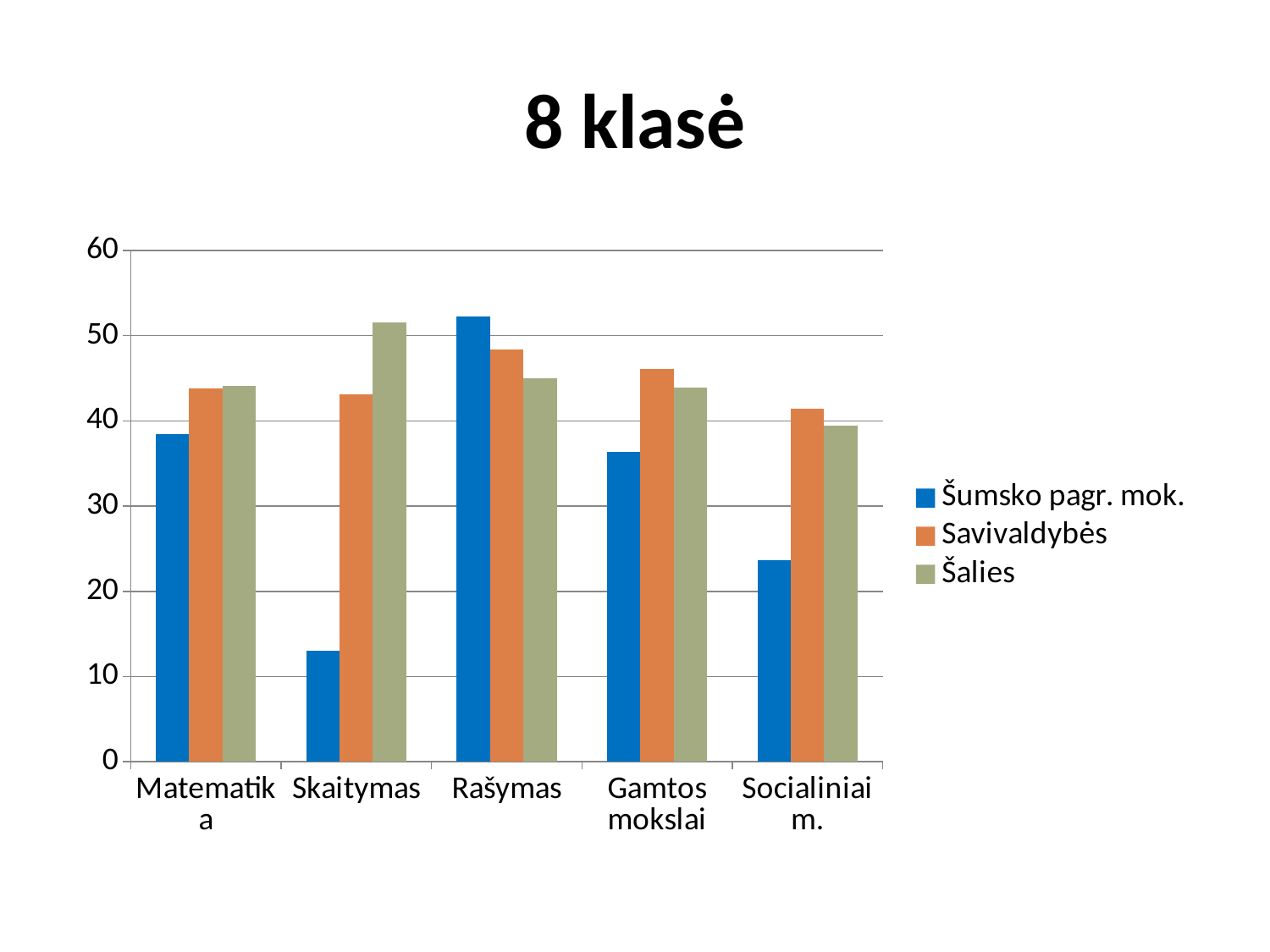
Is the Šumsko pagr. mok. value for Rašymas greater or less than 50? greater For which category is the Šalies value highest? Skaitymas Is the Šumsko pagr. mok. value for Skaitymas greater or less than 20? less How many series does the legend list? 3 How many categories are shown on the x axis? 5 For which category is the Šumsko pagr. mok. value lowest? Skaitymas What is the title of the chart? 8 klasė For Rašymas, which is larger: the Šumsko pagr. mok. value or the Savivaldybės value? Šumsko pagr. mok. For which category is the Šumsko pagr. mok. value highest? Rašymas What kind of chart is shown on the slide? bar chart For Skaitymas, which is larger: the Savivaldybės value or the Šalies value? Šalies For which category is the Šalies value lowest? Socialiniai m.